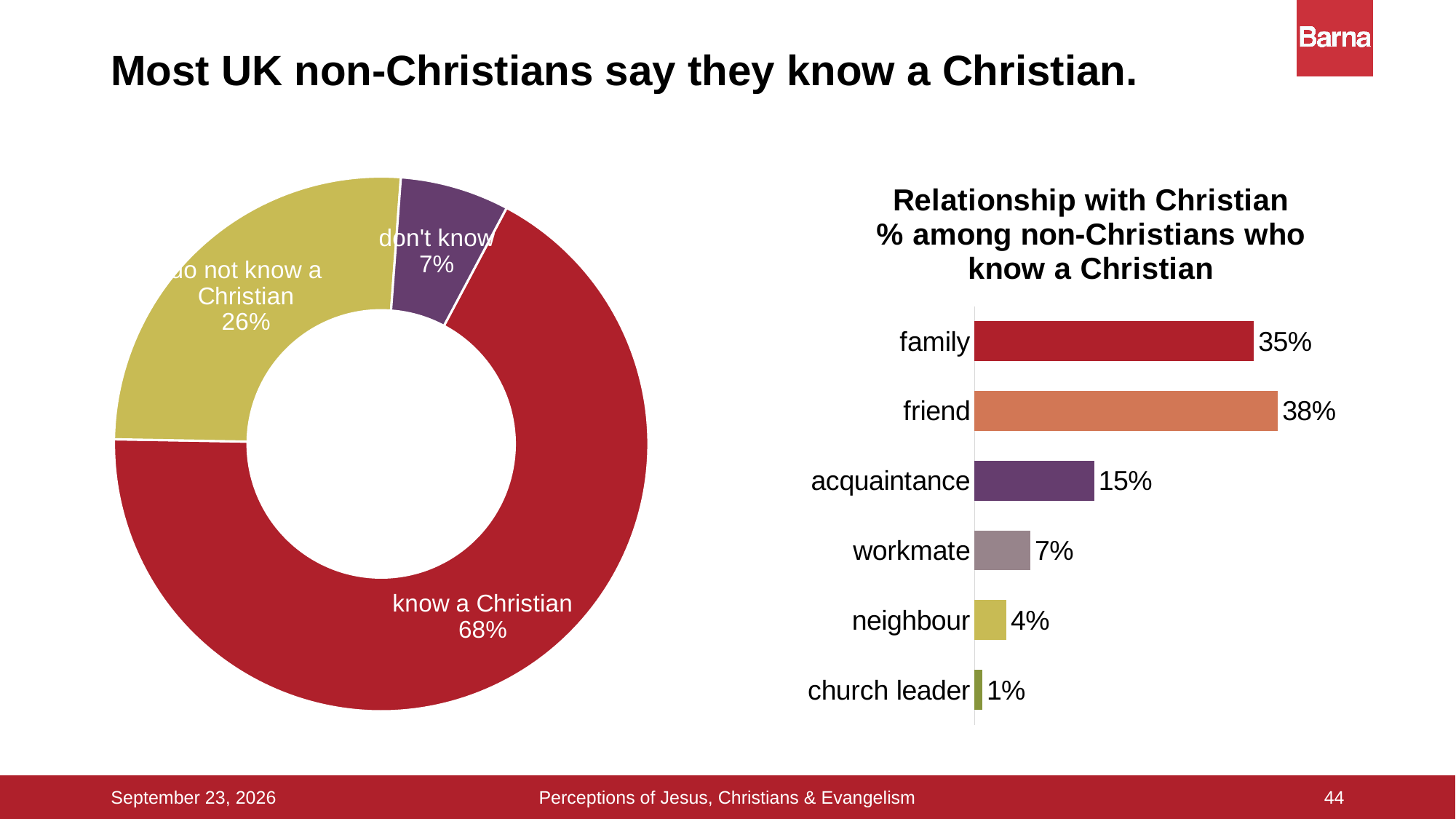
In the doughnut chart on the left, what percentage of UK non-Christians say they know a Christian? 68% In the doughnut chart on the left, how many slices are there? 3 In the 'Relationship with Christian' bar chart, how many categories are shown? 6 In the 'Relationship with Christian' bar chart, which category has the lowest value? church leader In the 'Relationship with Christian' bar chart, what is the value for acquaintance? 15% In the doughnut chart on the left, which slice is the largest? know a Christian What kind of chart is the one on the right of the slide? bar chart In the 'Relationship with Christian' bar chart, what is the difference between the values for family and workmate? 28% In the doughnut chart on the left, what percentage say they do not know a Christian? 26% In the doughnut chart on the left, what percentage answered 'don't know'? 7% In the 'Relationship with Christian' bar chart, which category has the highest value? friend In the 'Relationship with Christian' bar chart, what is the value for friend? 38%